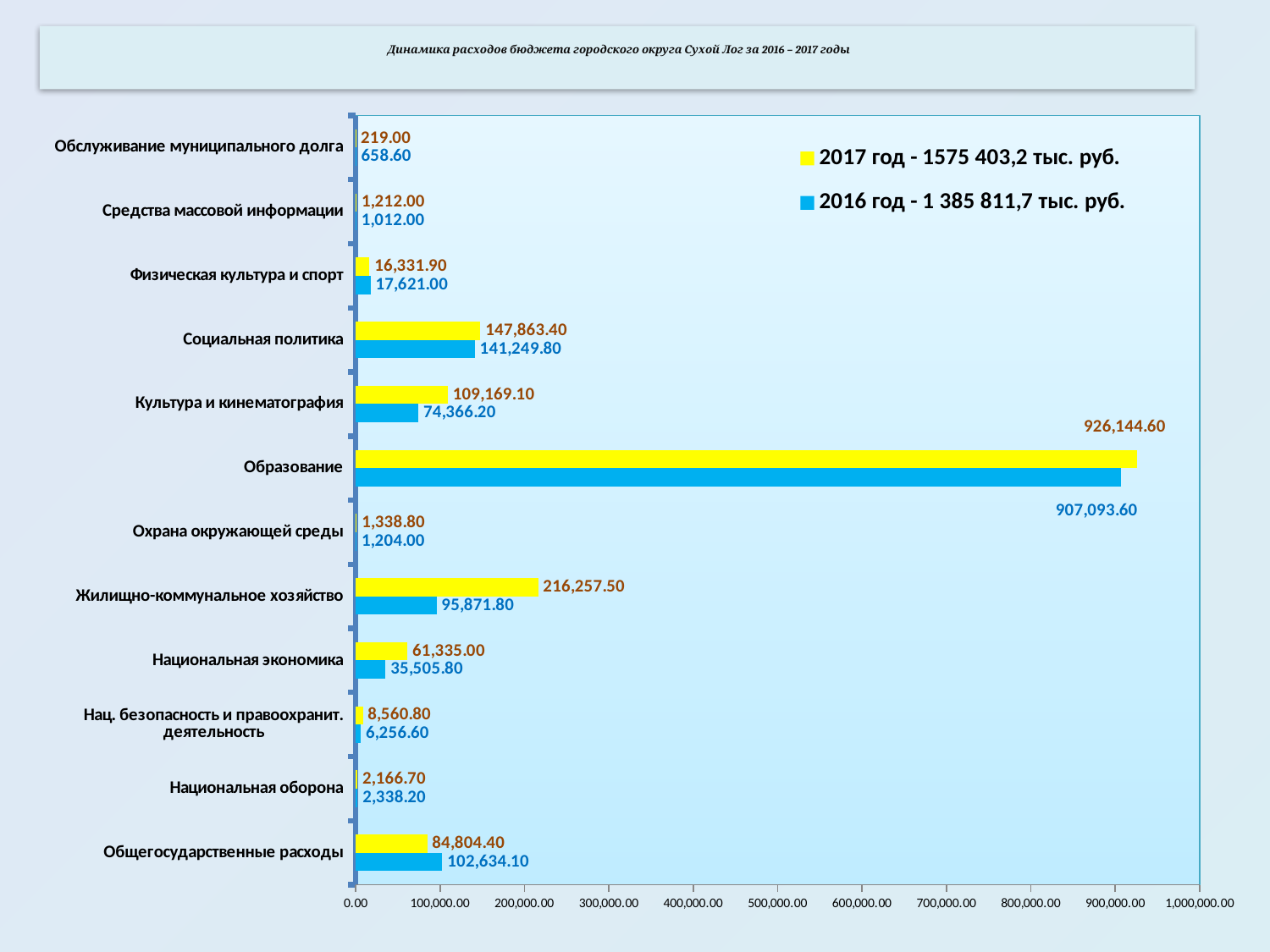
Which category has the lowest 2017 value? Обслуживание муниципального долга Which category has the highest 2017 value? Образование What is the difference between the 2017 and 2016 values for Образование? 19,051.00 What is the 2017 value for Социальная политика? 147,863.40 What is the difference between the 2017 and 2016 values for Жилищно-коммунальное хозяйство? 120,385.70 What type of chart is shown on the slide? Bar chart For Общегосударственные расходы, which year has the larger value, 2016 or 2017? 2016 What is the 2016 value for Жилищно-коммунальное хозяйство? 95,871.80 What is the 2017 value for Образование? 926,144.60 How many series does the legend list? 2 How many expenditure categories are shown on the chart? 12 Which colour represents the 2017 series in the legend? Yellow